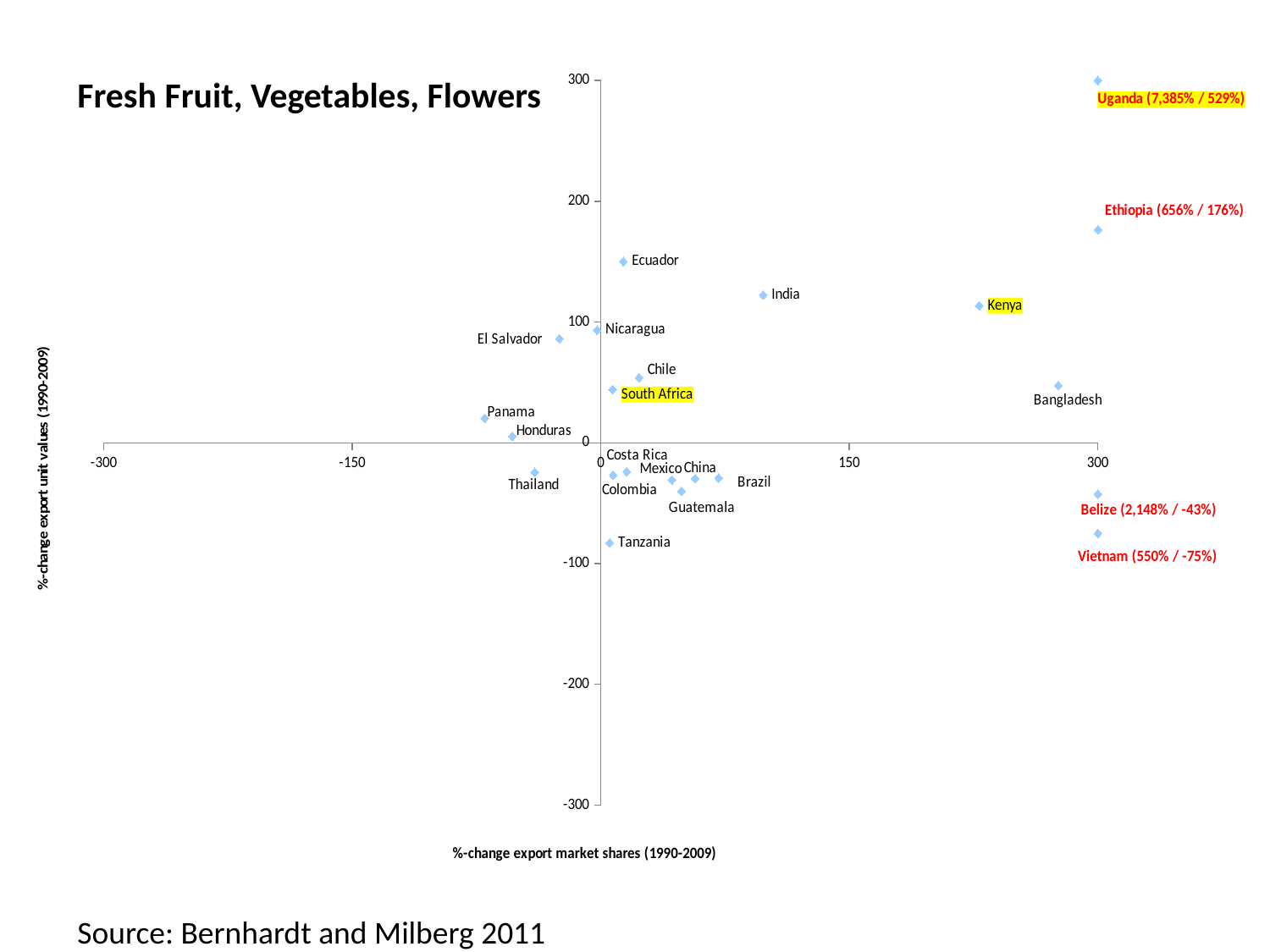
What %-change in export unit values is printed for Ethiopia? 176% Is the %-change in export market shares for Bangladesh greater or less than 150? greater What values are printed next to Uganda's label? 7,385% / 529% What kind of chart is shown on the slide? scatter chart What %-change in export market shares is printed for Belize? 2,148% What is the difference between the printed export unit value changes for Uganda (529%) and Ethiopia (176%)? 353 percentage points Which has the larger printed %-change in export market shares, Belize or Vietnam? Belize Which country has the highest %-change in export unit values? Uganda Which country has the lowest %-change in export unit values? Tanzania Is the %-change in export unit values for Ecuador greater or less than 100? greater What is the title of the chart? Fresh Fruit, Vegetables, Flowers What %-change in export unit values is printed for Vietnam? -75%